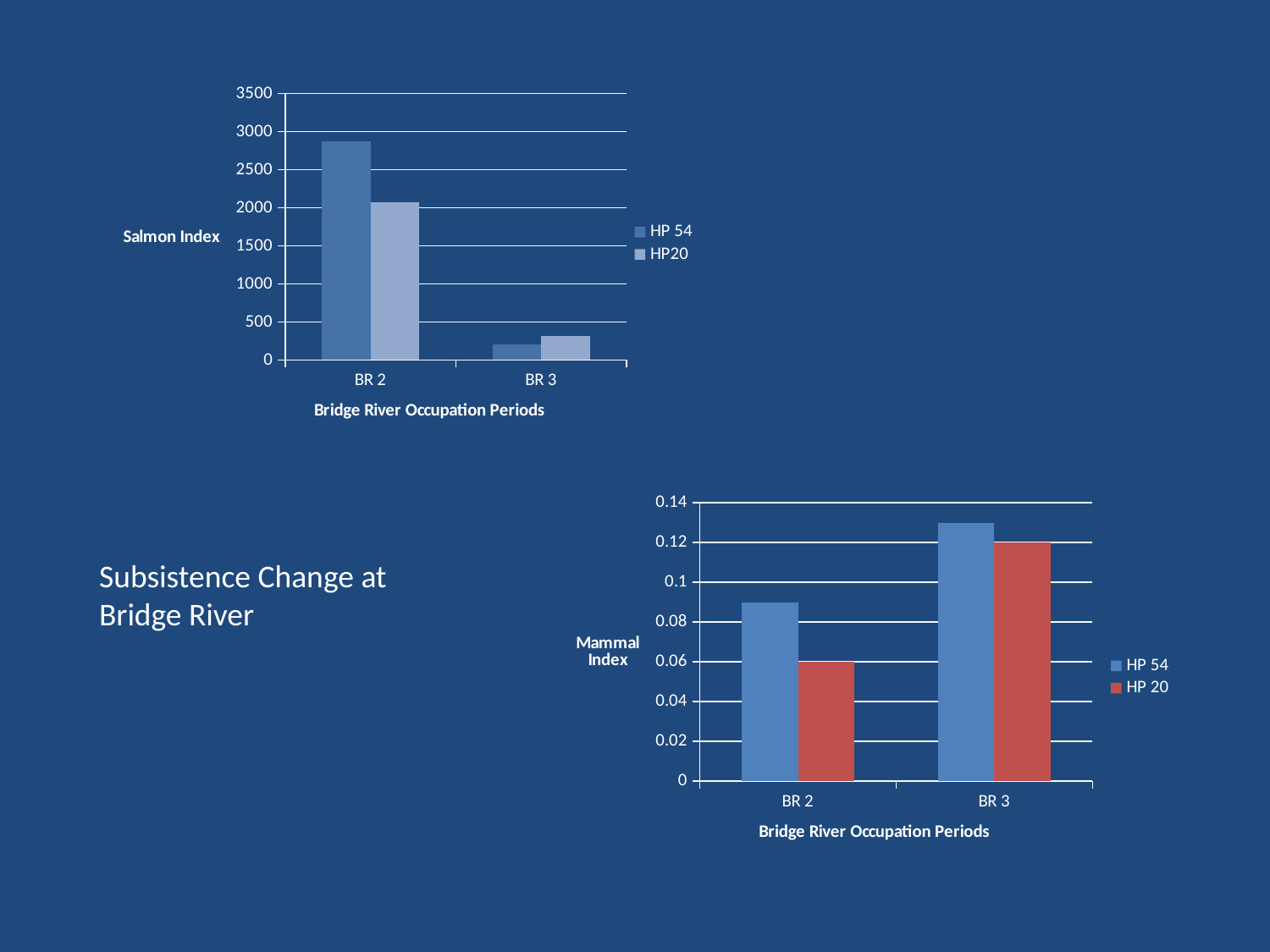
What kind of chart is the Salmon Index chart at the top of the slide? bar chart How many occupation periods are shown on the x axis of the Salmon Index chart? 2 In the Mammal Index chart, which series has the larger value for BR 2, HP 54 or HP 20? HP 54 How many series does the legend of the Mammal Index chart list? 2 In the Salmon Index chart, do the HP 54 values rise or fall from BR 2 to BR 3? fall In the Salmon Index chart, which occupation period has the highest HP 54 value? BR 2 In the Salmon Index chart, which series has the larger value for BR 2, HP 54 or HP20? HP 54 What is the x-axis title of the Mammal Index chart? Bridge River Occupation Periods In the Salmon Index chart, is the HP 54 value for BR 2 greater or less than 2500? greater In the Mammal Index chart, do the HP 54 values rise or fall from BR 2 to BR 3? rise In the Salmon Index chart, is the HP20 value for BR 3 greater or less than 500? less In the Mammal Index chart, is the HP 54 value for BR 3 greater or less than 0.12? greater